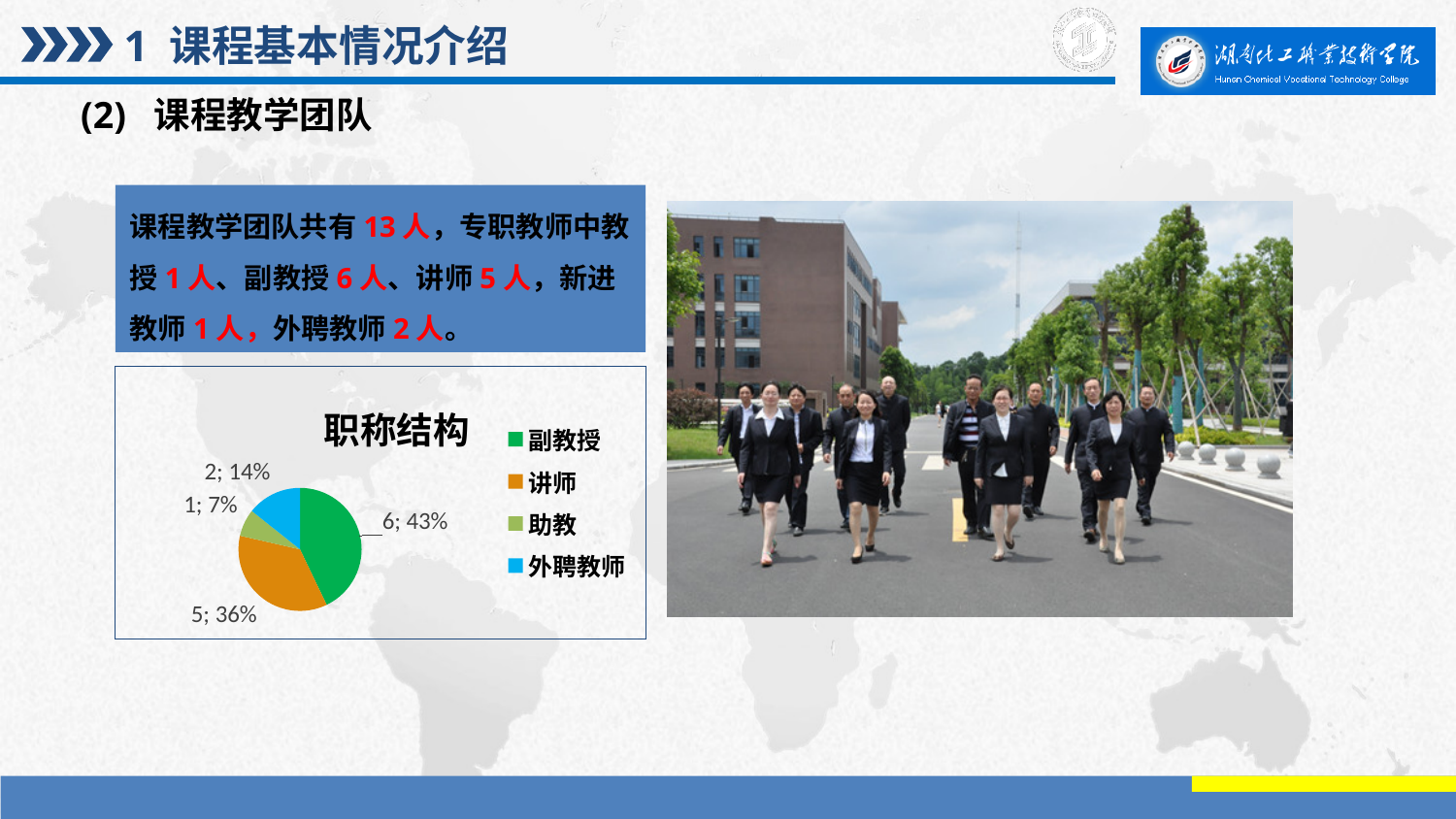
What type of chart is shown under the title 职称结构? pie chart What percentage share does 外聘教师 have in the pie chart? 14% What percentage share does 讲师 have in the pie chart? 36% Which category has the smallest slice in the pie chart? 助教 What is the title of the pie chart? 职称结构 Which category has the largest slice in the pie chart? 副教授 What is the difference in count between 副教授 and 讲师 in the pie chart? 1 What is the count shown for 助教 in the pie chart? 1 How many categories does the legend of the pie chart list? 4 What is the count shown for 副教授 in the pie chart? 6 How many slices does the pie chart have? 4 Which is larger in the pie chart, 外聘教师 or 助教? 外聘教师